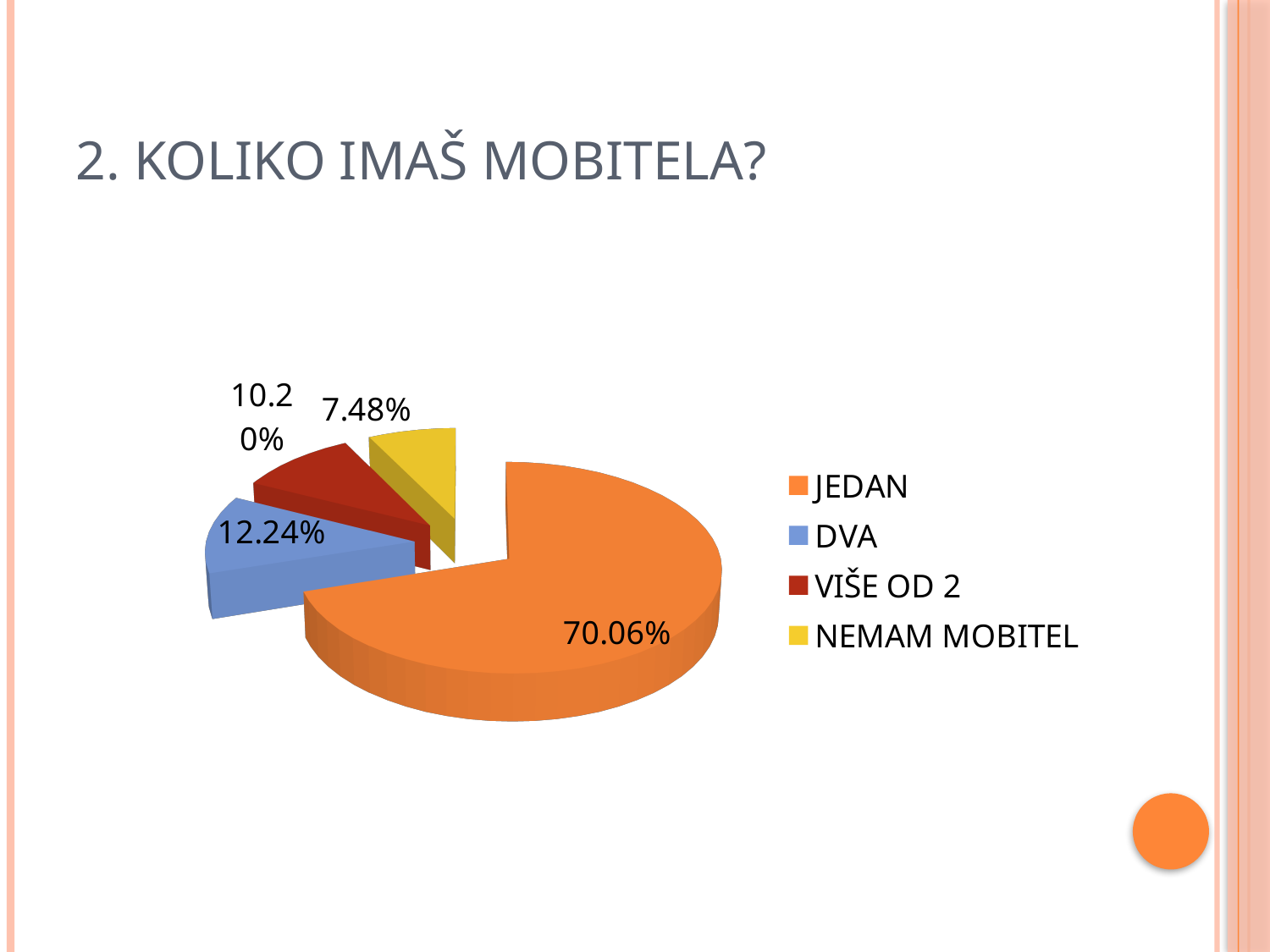
What is the share for VIŠE OD 2? 10.20% What is the title of the slide? 2. KOLIKO IMAŠ MOBITELA? What colour is the slice for VIŠE OD 2? red What is the share for JEDAN? 70.06% How many categories does the legend list? 4 Which is larger, the slice for DVA or the slice for NEMAM MOBITEL? DVA What is the share for DVA? 12.24% Which category has the smallest slice of the pie? NEMAM MOBITEL What is the share for NEMAM MOBITEL? 7.48% What kind of chart is shown on the slide? pie chart What is the difference between the share for JEDAN and the share for DVA? 57.82% Which category has the largest slice of the pie? JEDAN